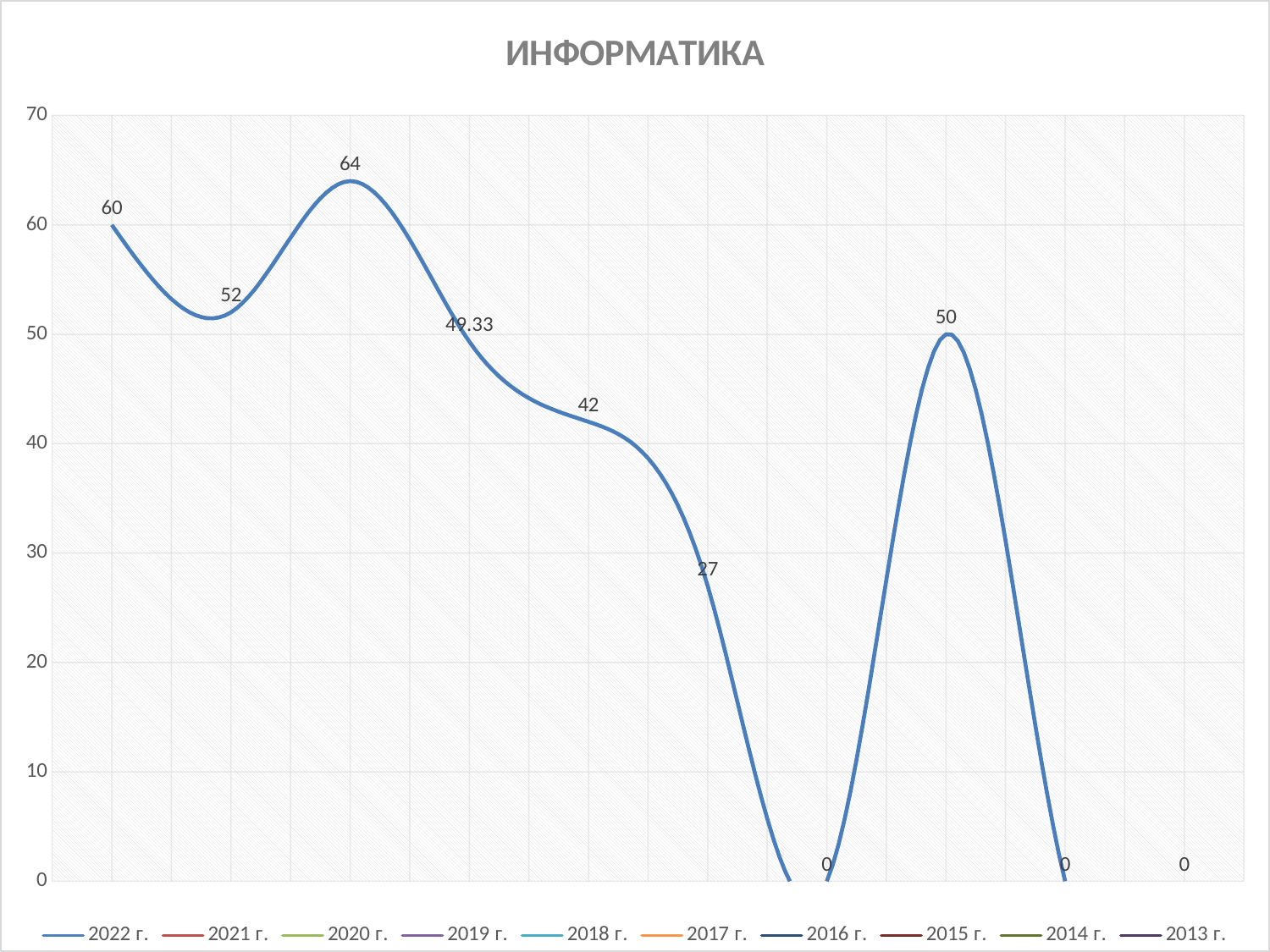
What is the value of the first (leftmost) labeled point on the line? 60 What is the highest labeled value on the line? 64 What type of chart is shown on the slide? line chart How many entries does the chart's legend list? 10 What is the difference between the highest labeled value (64) and the first point's value (60)? 4 How many data points are labeled on the line? 10 Which is larger, the second labeled point (52) or the fifth labeled point (42)? 52 What is the difference between the labeled values 50 and 27? 23 What is the lowest labeled value on the line? 0 What is the value of the fourth labeled point from the left on the line? 49.33 What is the title of the chart? ИНФОРМАТИКА From the point labeled 64 to the point labeled 27, do the values rise or fall along the x axis? fall